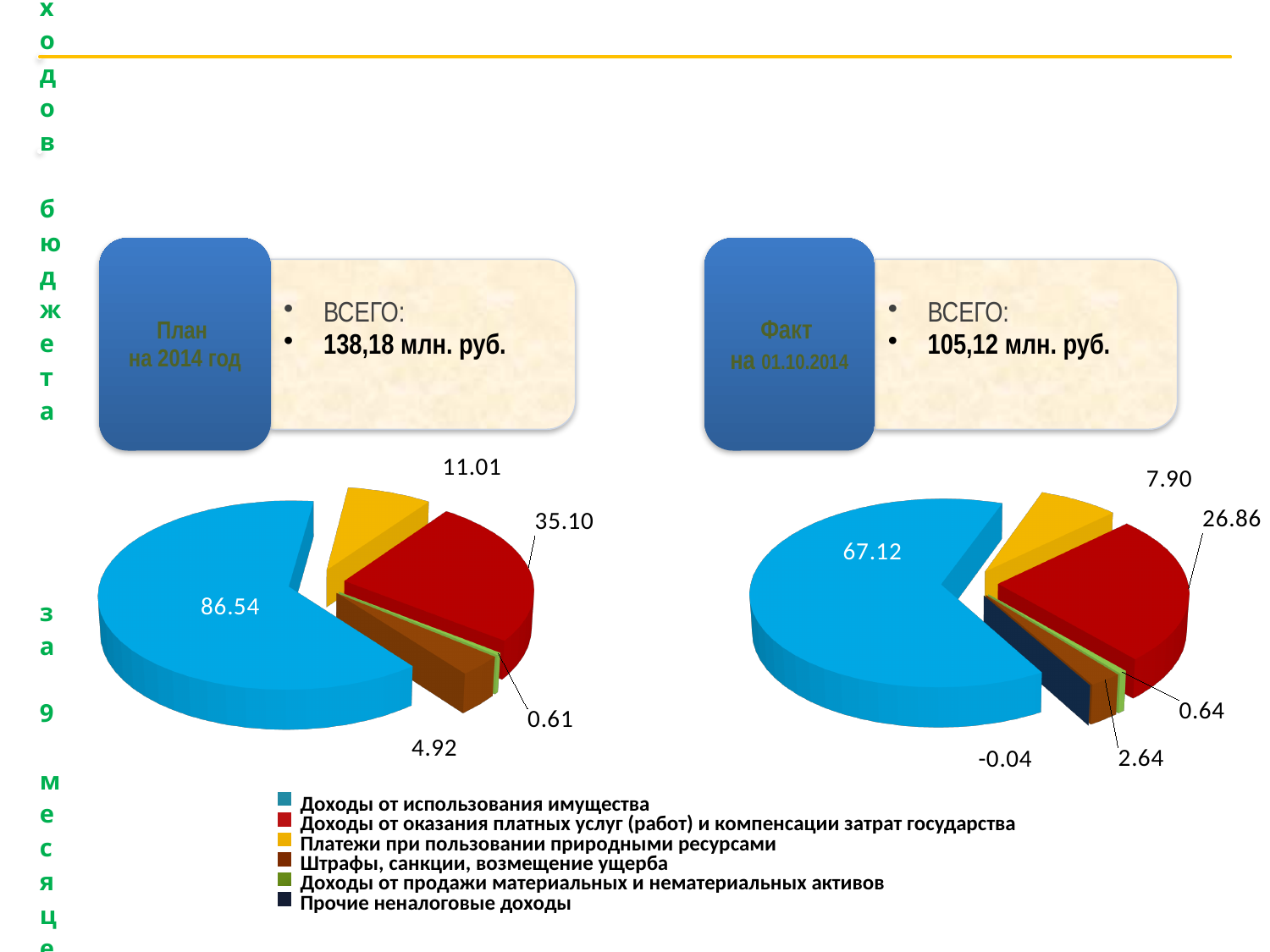
In the right pie chart (Факт на 01.10.2014), what is the value for Прочие неналоговые доходы? -0.04 In the right pie chart (Факт на 01.10.2014), which is larger: Штрафы, санкции, возмещение ущерба or Платежи при пользовании природными ресурсами? Платежи при пользовании природными ресурсами In the left pie chart (План на 2014 год), what is the value for Платежи при пользовании природными ресурсами? 11.01 In the right pie chart (Факт на 01.10.2014), what is the value for Доходы от оказания платных услуг (работ) и компенсации затрат государства? 26.86 How many slices does the right pie chart (Факт на 01.10.2014) have data labels for? 6 What is the difference between the value for Доходы от использования имущества in the left pie chart (86.54) and in the right pie chart (67.12)? 19.42 In the left pie chart (План на 2014 год), which category has the smallest value? Доходы от продажи материальных и нематериальных активов In the left pie chart (План на 2014 год), what is the value for Доходы от использования имущества? 86.54 What type of chart is used on this slide? Pie chart In the left pie chart (План на 2014 год), which category has the largest value? Доходы от использования имущества How many entries does the shared legend list? 6 In the right pie chart (Факт на 01.10.2014), which category has the smallest value? Прочие неналоговые доходы